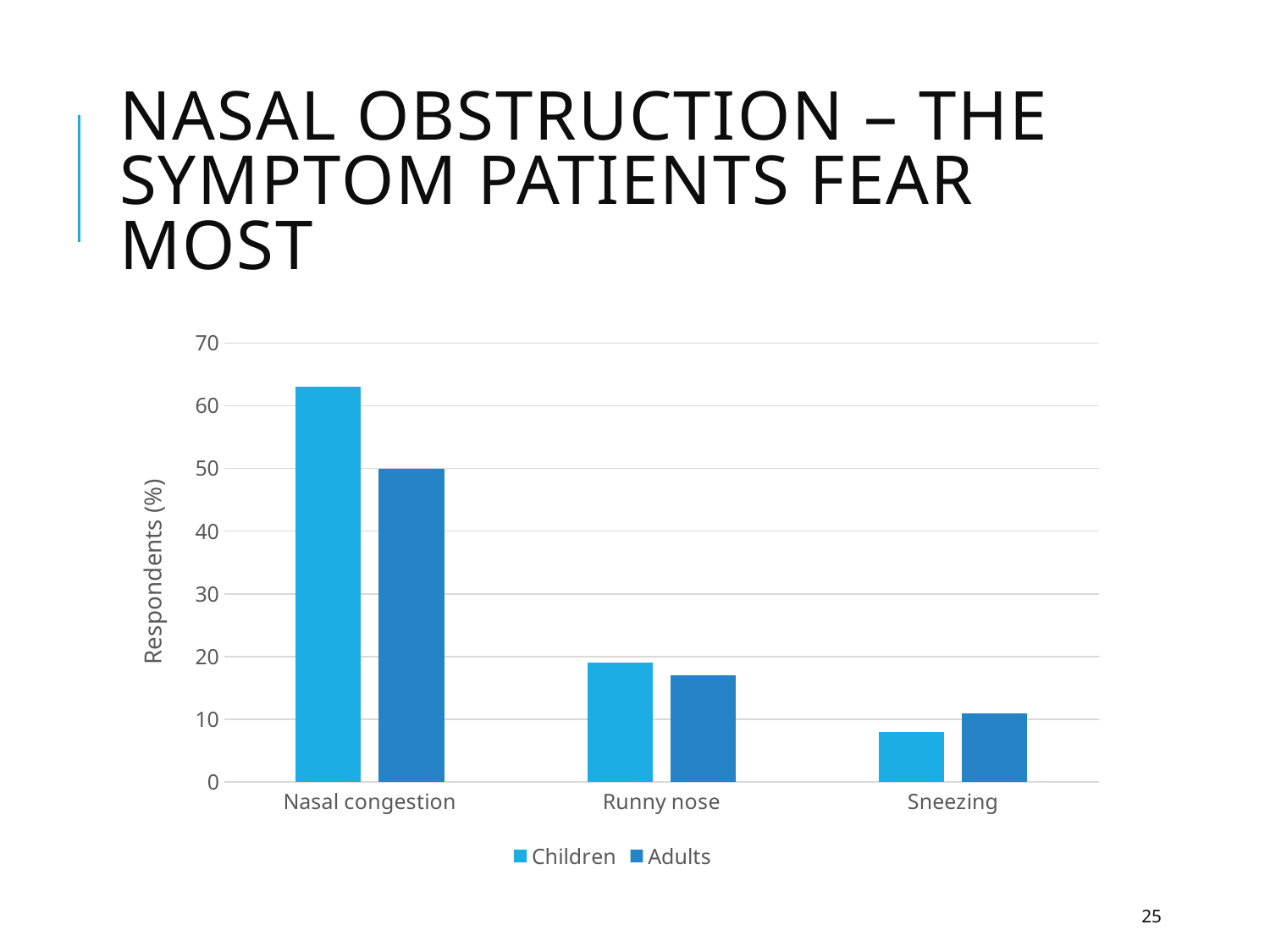
Is the Children value for Sneezing greater or less than 10? less How many series does the legend list? 2 For Nasal congestion, which series has the larger value, Children or Adults? Children Which symptom has the highest value for Children? Nasal congestion What kind of chart is shown on the slide? Bar chart Do the Children values rise or fall from Nasal congestion to Sneezing along the x axis? Fall How many symptom categories are shown on the x axis? 3 Which symptom has the lowest value for Adults? Sneezing Is the Adults value for Runny nose greater or less than 20? less Is the Children value for Nasal congestion greater or less than 60? greater For Sneezing, which series has the larger value, Children or Adults? Adults